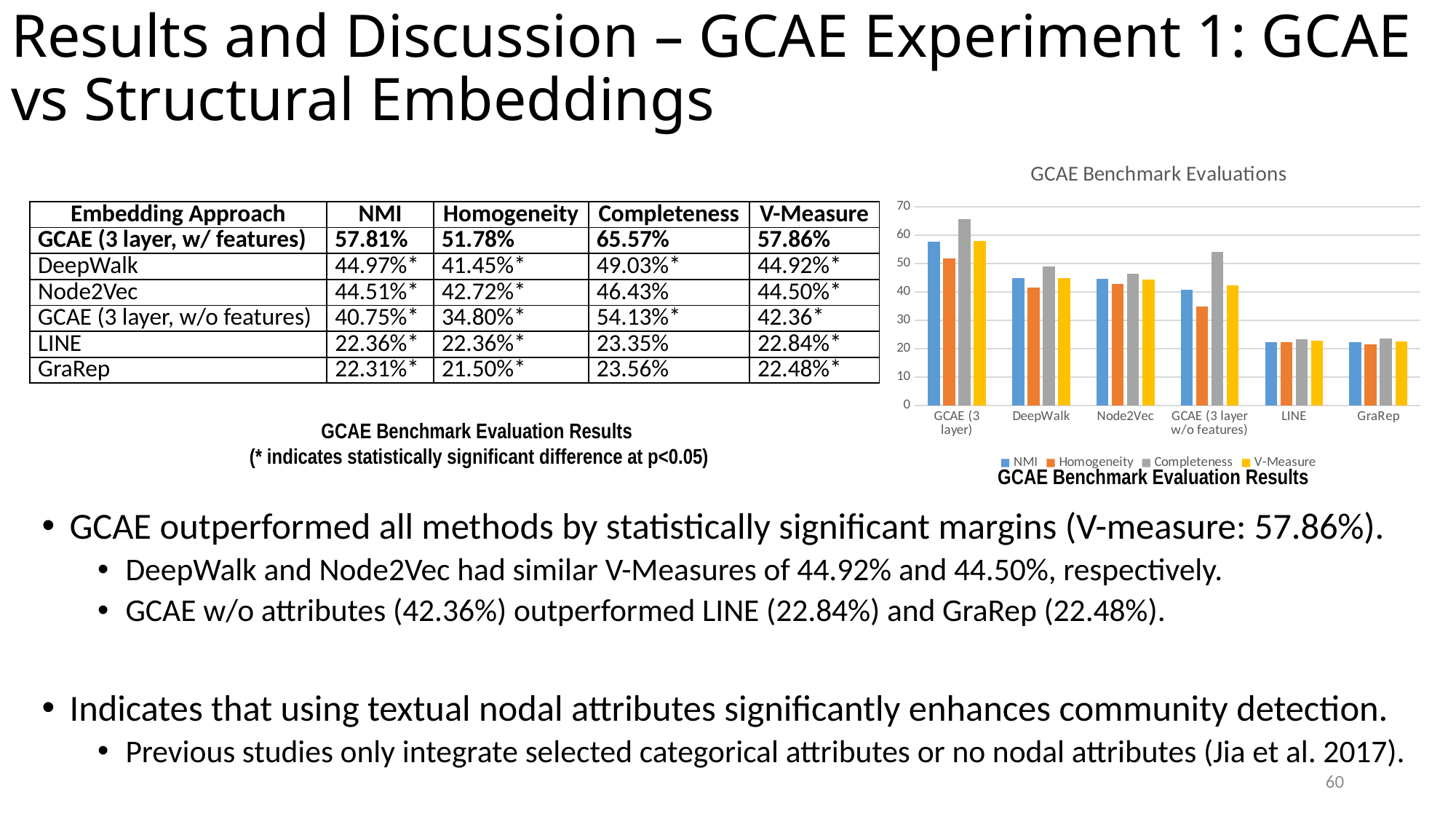
In the GCAE Benchmark Evaluations chart, which category has the tallest bar overall? GCAE (3 layer) According to the slide, what is the V-Measure value for GCAE (3 layer, w/ features)? 57.86% In the GCAE Benchmark Evaluations chart, is the Completeness value for GCAE (3 layer) greater or less than 60? greater Which series are listed in the legend of the GCAE Benchmark Evaluations chart? NMI, Homogeneity, Completeness, V-Measure What type of chart is shown under the title 'GCAE Benchmark Evaluations'? bar chart In the GCAE Benchmark Evaluations chart, is the Completeness value for GCAE (3 layer w/o features) greater or less than 50? greater In the GCAE Benchmark Evaluations chart, is the NMI value for LINE greater or less than 30? less In the GCAE Benchmark Evaluations chart, which is larger: the NMI value for GCAE (3 layer) or the NMI value for DeepWalk? GCAE (3 layer) How many embedding approaches (categories) are shown on the x axis of the GCAE Benchmark Evaluations chart? 6 In the GCAE Benchmark Evaluations chart, do the NMI values generally rise or fall moving left to right across the categories? fall In the GCAE Benchmark Evaluations chart, which series has the highest value for GCAE (3 layer)? Completeness How many series does the legend of the GCAE Benchmark Evaluations chart list? 4